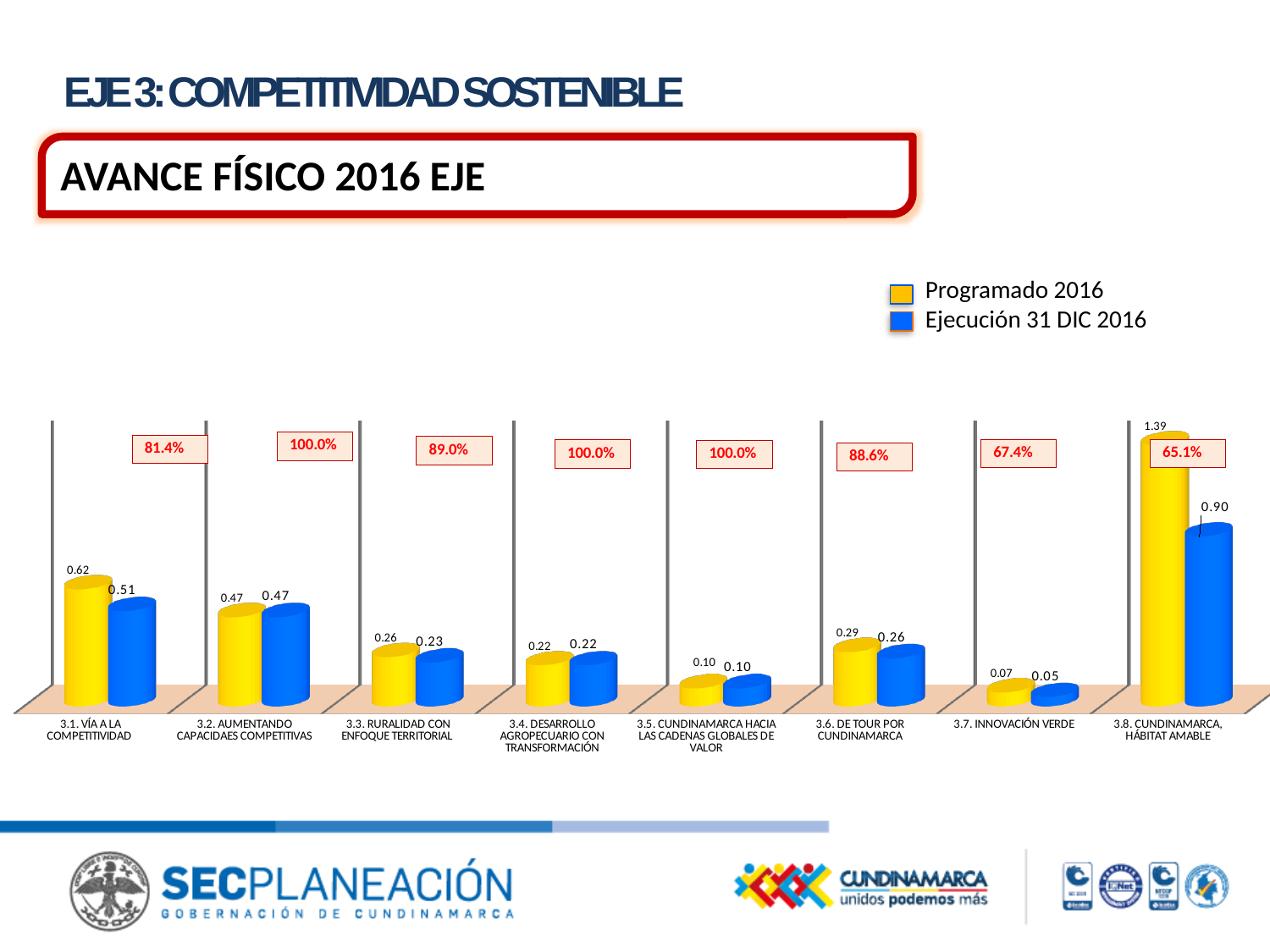
Which is larger, the Programado 2016 value for 3.3. RURALIDAD CON ENFOQUE TERRITORIAL or the Programado 2016 value for 3.6. DE TOUR POR CUNDINAMARCA? 3.6. DE TOUR POR CUNDINAMARCA What is the Programado 2016 value for 3.8. CUNDINAMARCA, HÁBITAT AMABLE? 1.39 Which category has the highest Programado 2016 value? 3.8. CUNDINAMARCA, HÁBITAT AMABLE What kind of chart is shown on the slide? Bar chart How many series does the legend list? 2 What is the Ejecución 31 DIC 2016 value for 3.1. VÍA A LA COMPETITIVIDAD? 0.51 Which category has the lowest Ejecución 31 DIC 2016 value? 3.7. INNOVACIÓN VERDE What is the difference between the Programado 2016 and Ejecución 31 DIC 2016 values for 3.8. CUNDINAMARCA, HÁBITAT AMABLE? 0.49 What percentage is shown above the bars for 3.7. INNOVACIÓN VERDE? 67.4% How many categories are shown on the x axis of the chart? 8 What is the Programado 2016 value for 3.6. DE TOUR POR CUNDINAMARCA? 0.29 What is the difference between the Programado 2016 and Ejecución 31 DIC 2016 values for 3.1. VÍA A LA COMPETITIVIDAD? 0.11